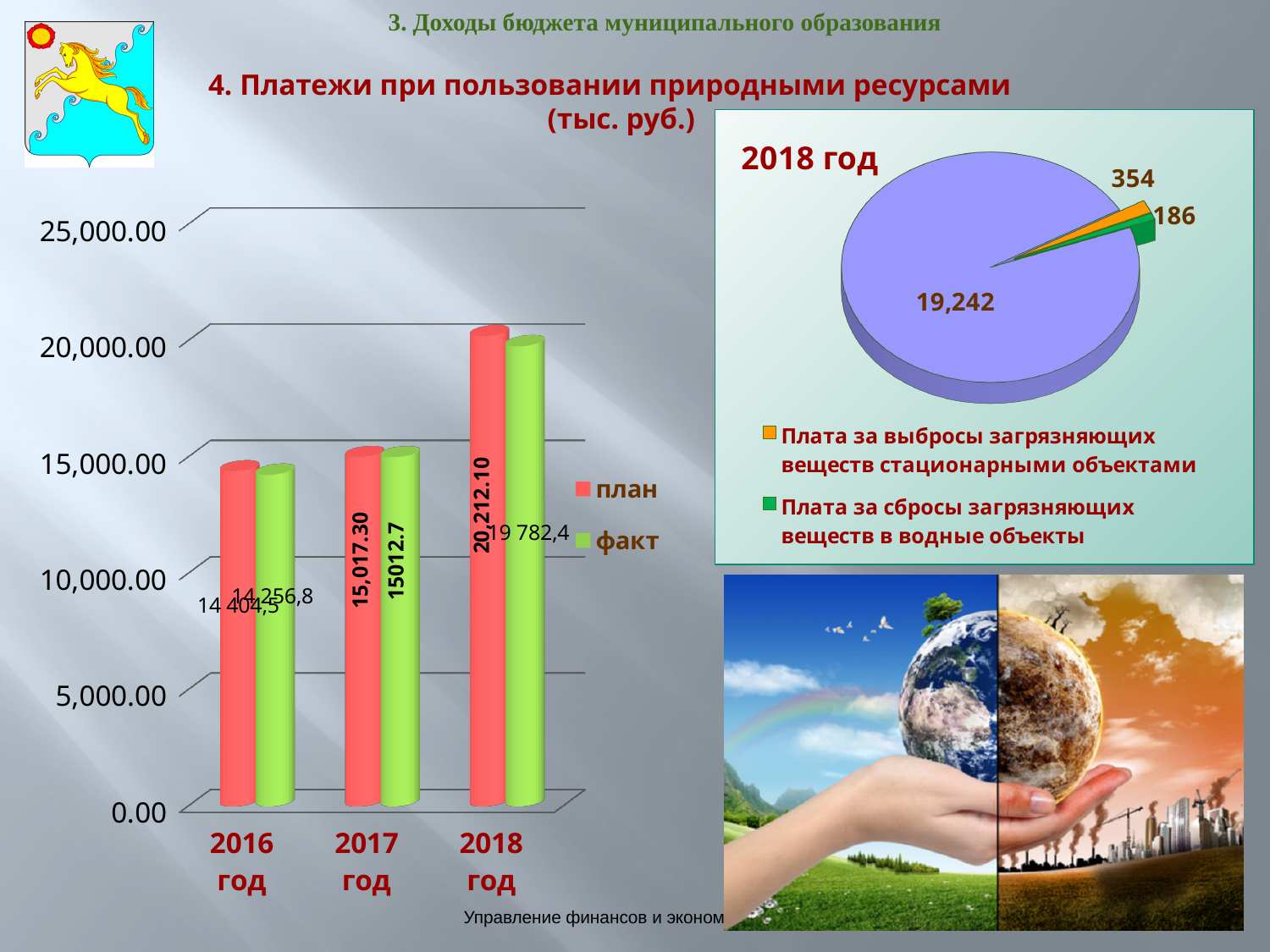
On the bar chart, which year has the highest план value? 2018 год On the pie chart for 2018 год, what is the value for Плата за сбросы загрязняющих веществ в водные объекты? 186 On the bar chart, what is the value for факт in 2017 год? 15012.7 On the pie chart for 2018 год, what is the value for Плата за выбросы загрязняющих веществ стационарными объектами? 354 On the bar chart, what is the value for план in 2018 год? 20,212.10 On the bar chart, what is the value for план in 2017 год? 15,017.30 On the bar chart, what is the value for факт in 2018 год? 19 782,4 On the bar chart, how many series does the legend list? 2 On the bar chart, do the факт values rise or fall from 2016 год to 2018 год? rise What kind of chart is the chart on the left of the slide? bar chart On the bar chart, what is the value for факт in 2016 год? 14 256,8 On the bar chart, which is larger in 2018 год: план or факт? план